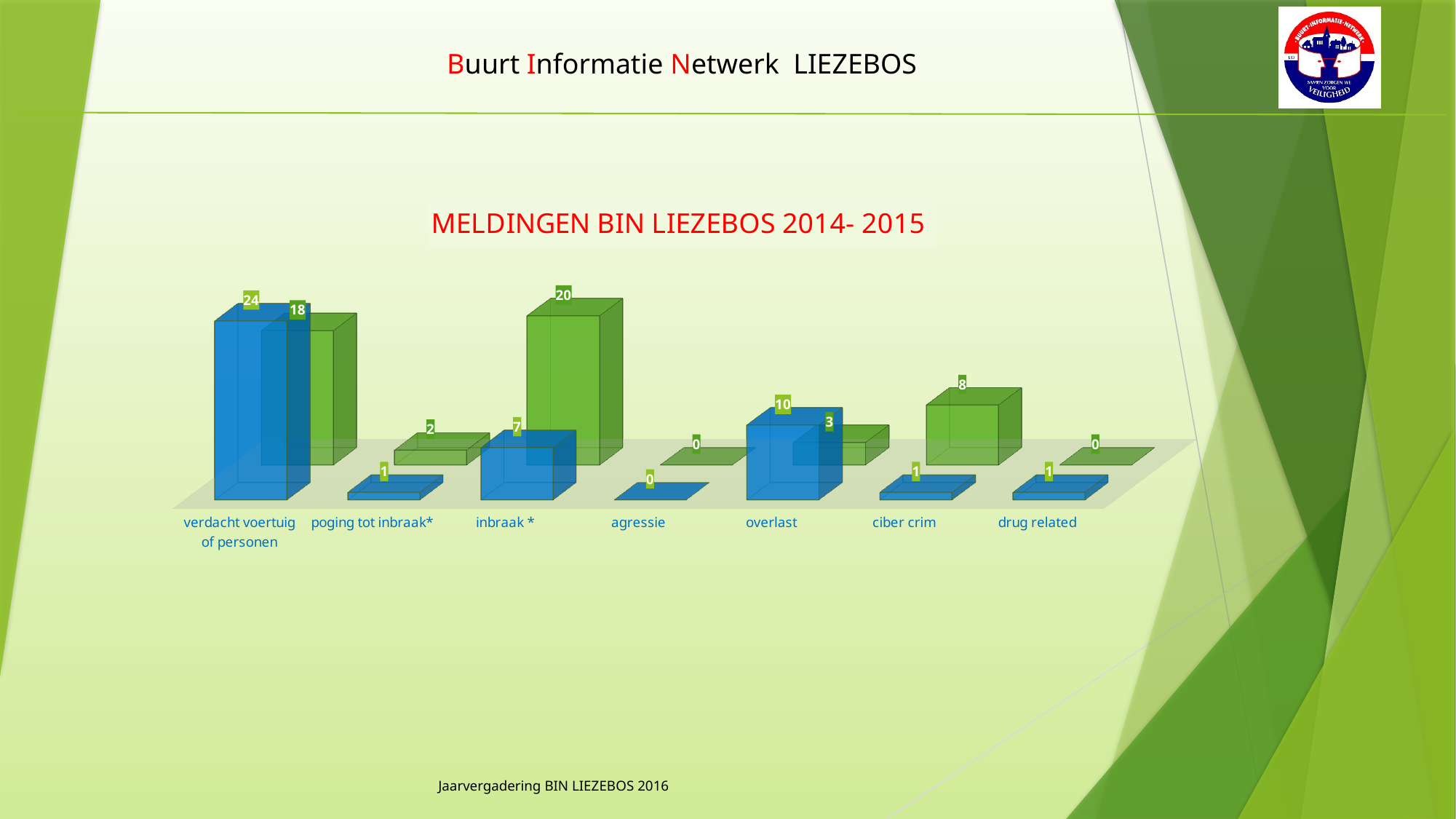
What kind of chart is shown on the slide? bar chart Which category has the highest green bar? inbraak * What is the difference between the blue and green bars for 'verdacht voertuig of personen'? 6 Which category has the highest blue bar? verdacht voertuig of personen What is the value of the blue bar for 'overlast'? 10 How many categories are shown on the x axis of the chart? 7 What is the difference between the green and blue bars for 'inbraak *'? 13 What is the title of the chart? MELDINGEN BIN LIEZEBOS 2014- 2015 For 'overlast', which bar is larger, the blue or the green one? blue What is the value of the blue bar for 'verdacht voertuig of personen'? 24 What is the value of the green bar for 'ciber crim'? 8 What is the value of the green bar for 'inbraak *'? 20